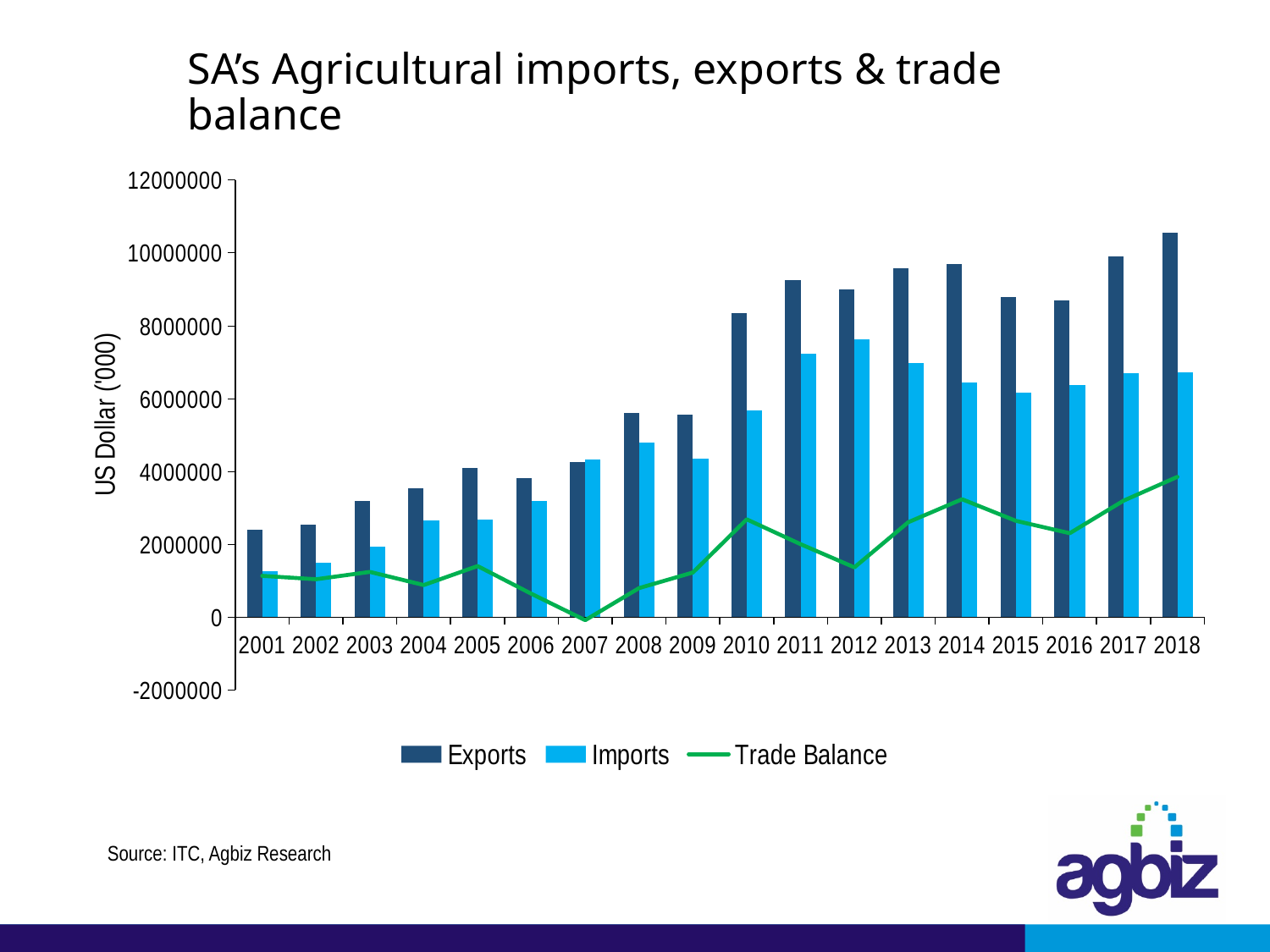
Do Exports generally rise or fall from 2001 to 2018? rise In which year is the Trade Balance at its lowest? 2007 Is the Exports value for 2011 greater or less than 8000000? greater How many years are shown on the x axis? 18 Is the Trade Balance value for 2014 greater or less than 2000000? greater In 2018, which is larger, Exports or Imports? Exports Which year has the highest Exports value? 2018 Which year has the lowest Imports value? 2001 What is the label on the vertical axis? US Dollar ('000) Is the Exports value for 2018 greater or less than 10000000? greater How many series does the legend list? 3